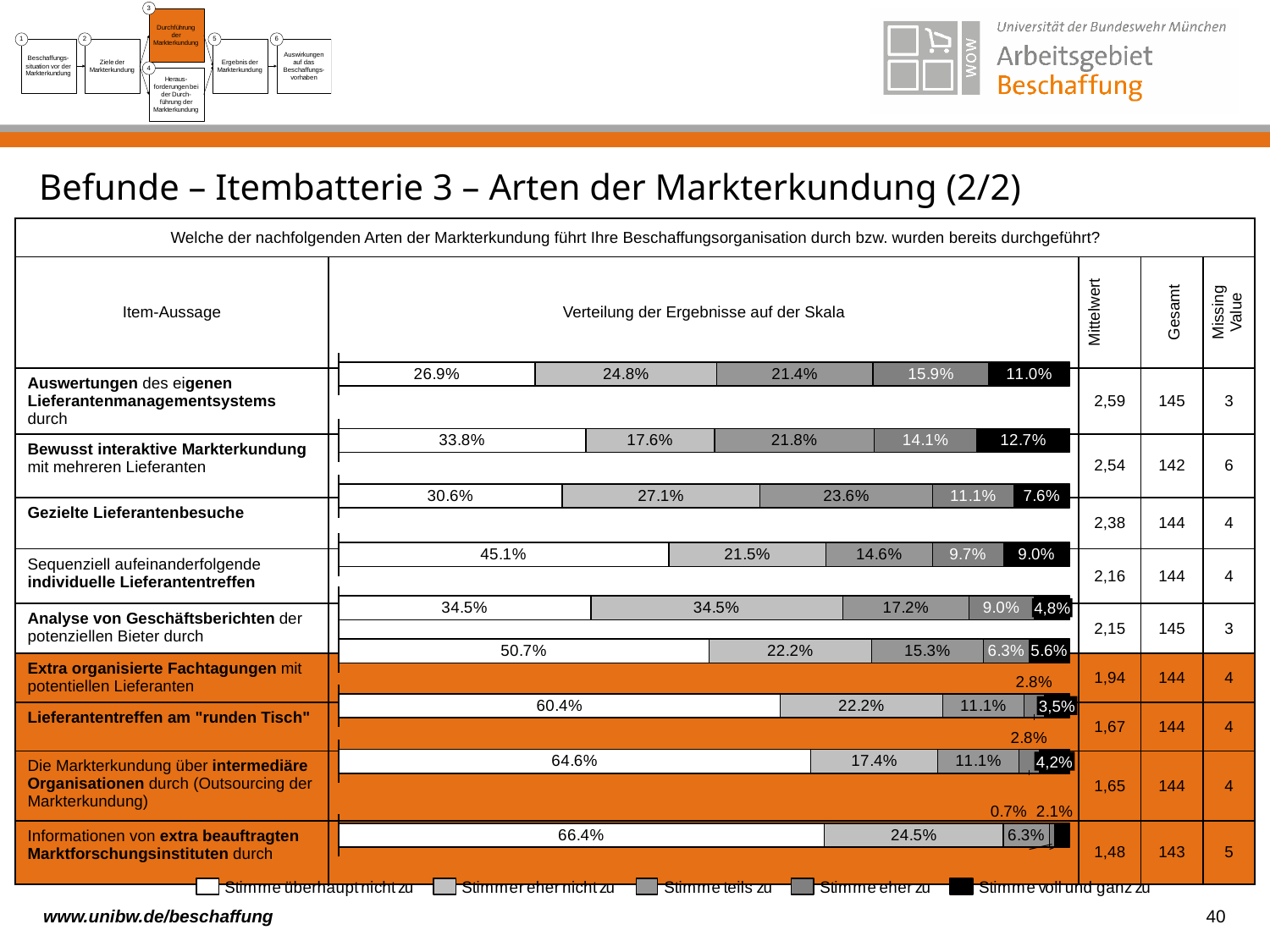
What is the 'Stimme voll und ganz zu' share for 'Bewusst interaktive Markterkundung mit mehreren Lieferanten'? 12.7% What is the 'Stimme eher zu' share for 'Analyse von Geschäftsberichten der potenziellen Bieter durch'? 9.0% How many series does the legend list? 5 What is the 'Stimme überhaupt nicht zu' share for 'Gezielte Lieferantenbesuche'? 30.6% What is the 'Stimme eher nicht zu' share for 'Informationen von extra beauftragten Marktforschungsinstituten durch'? 24.5% Which item has the lowest 'Stimme überhaupt nicht zu' share? Auswertungen des eigenen Lieferantenmanagementsystems durch Which is larger: the 'Stimme teils zu' share for 'Gezielte Lieferantenbesuche' or for 'Auswertungen des eigenen Lieferantenmanagementsystems durch'? Gezielte Lieferantenbesuche Which legend entry is shown with a black fill? Stimme voll und ganz zu How many item statements (bars) are plotted in the chart? 9 What is the difference between the 'Stimme überhaupt nicht zu' shares of 'Extra organisierte Fachtagungen mit potentiellen Lieferanten' and 'Sequenziell aufeinanderfolgende individuelle Lieferantentreffen'? 5.6% Which item has the highest 'Stimme überhaupt nicht zu' share? Informationen von extra beauftragten Marktforschungsinstituten durch What kind of chart is shown on the slide? stacked bar chart